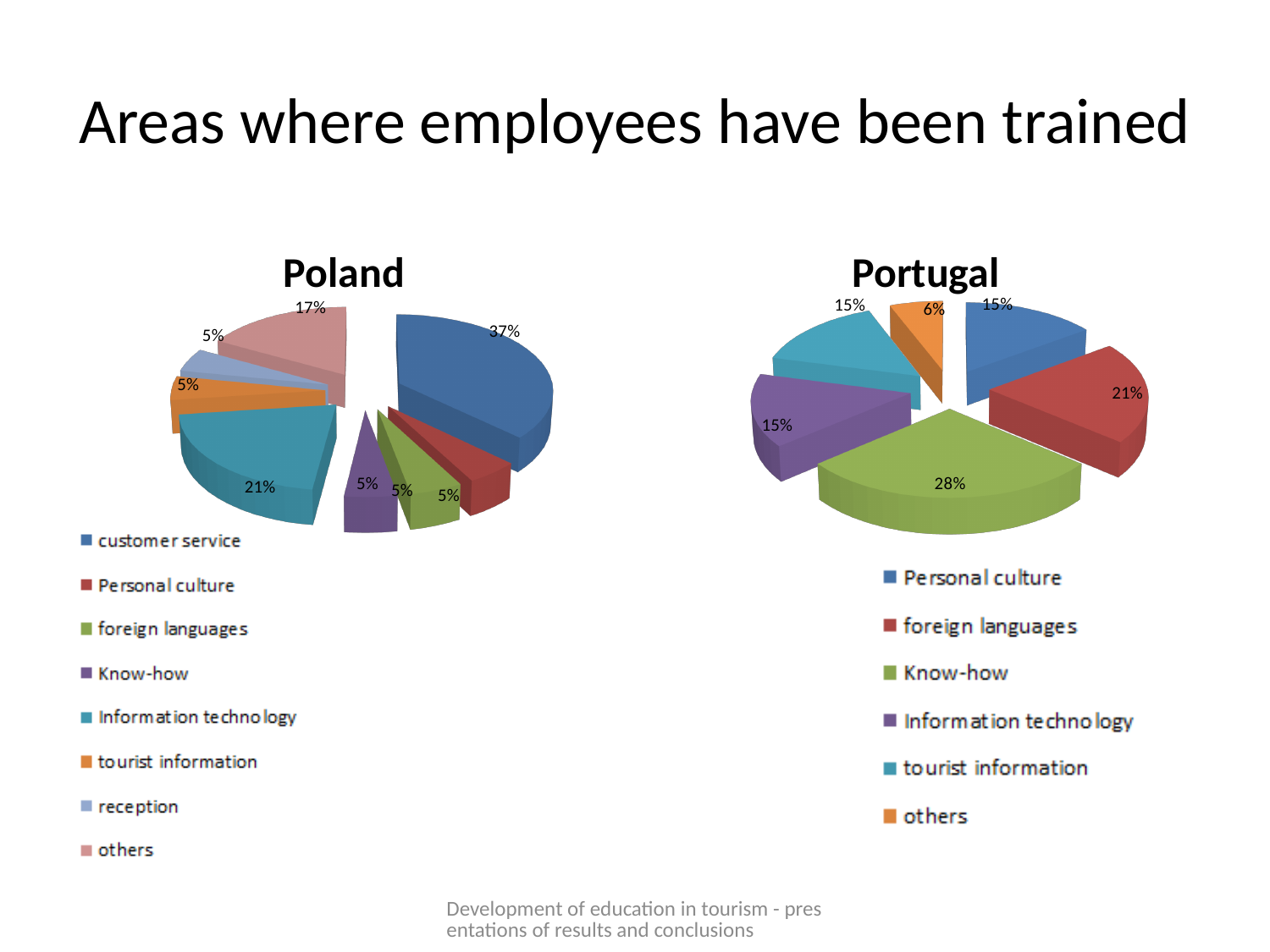
In the Poland chart, which is larger: the share for customer service or the share for Information technology? customer service In the Portugal chart, what share is shown for Know-how? 28% In the Portugal chart, what is the difference between the shares for Know-how and foreign languages? 7% In the Portugal chart, which training area has the smallest share? others In the Poland chart, which training area has the largest share? customer service In the Portugal chart, which training area has the largest share? Know-how In the Poland chart, what share is shown for Information technology? 21% In the Poland chart, what share of employees were trained in customer service? 37% In the Portugal chart, what share is shown for foreign languages? 21% How many categories does the legend of the Poland chart list? 8 In the Poland chart, what share is shown for others? 17% What type of chart is used for Portugal? Pie chart